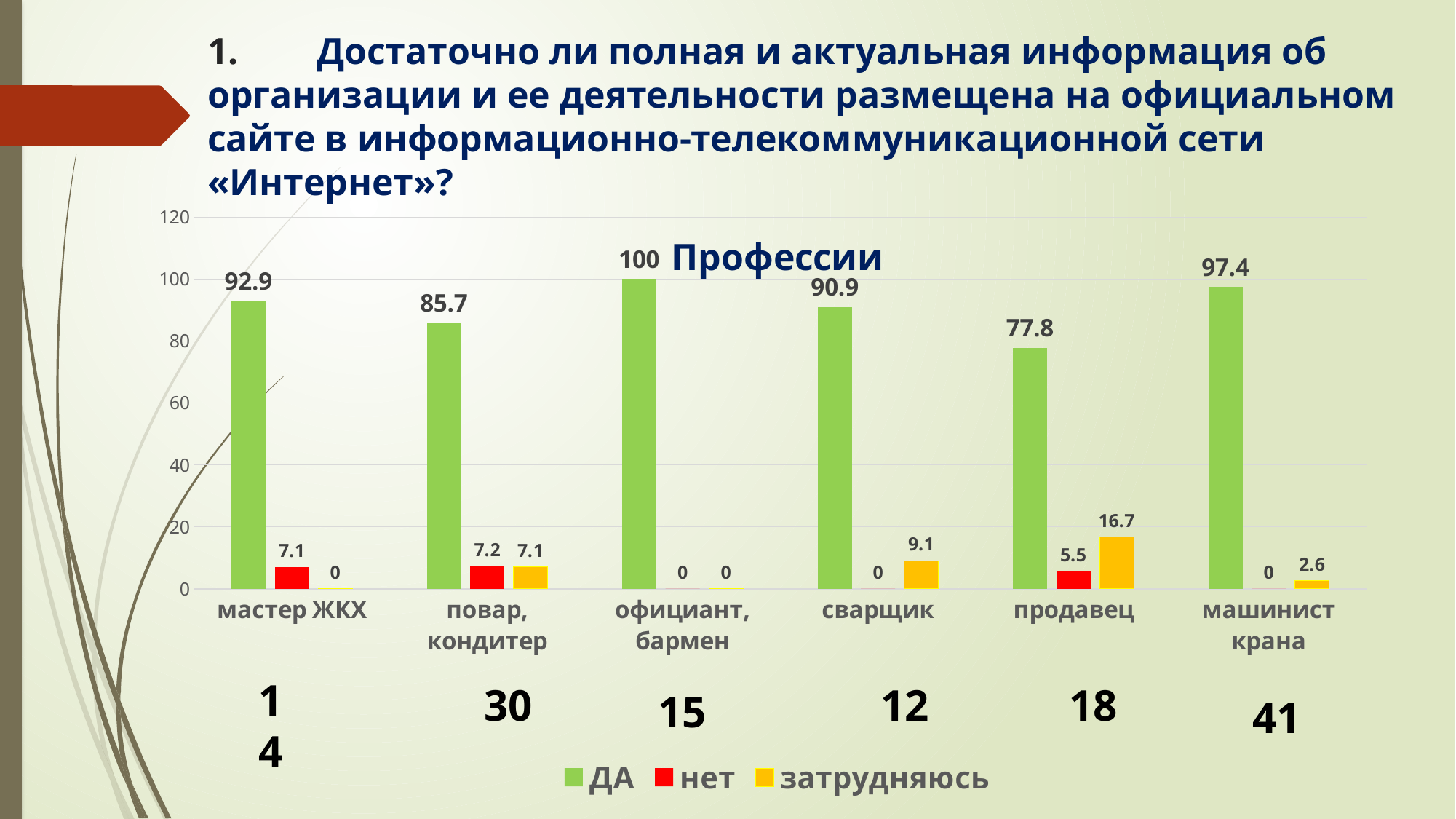
How many categories are shown on the x axis? 6 Which is larger: the ДА value for сварщик or the ДА value for повар, кондитер? сварщик What kind of chart is shown on the slide? bar chart Which category has the lowest value in the ДА series? продавец What is the value of the затрудняюсь series for продавец? 16.7 Which category has the highest value in the затрудняюсь series? продавец What is the difference between the ДА values for машинист крана and мастер ЖКХ? 4.5 What is the value of the нет series for повар, кондитер? 7.2 Is the ДА value for продавец greater or less than 80? less How many series does the legend list? 3 What is the value of the ДА series for официант, бармен? 100 What colour represents the нет series in the chart? red